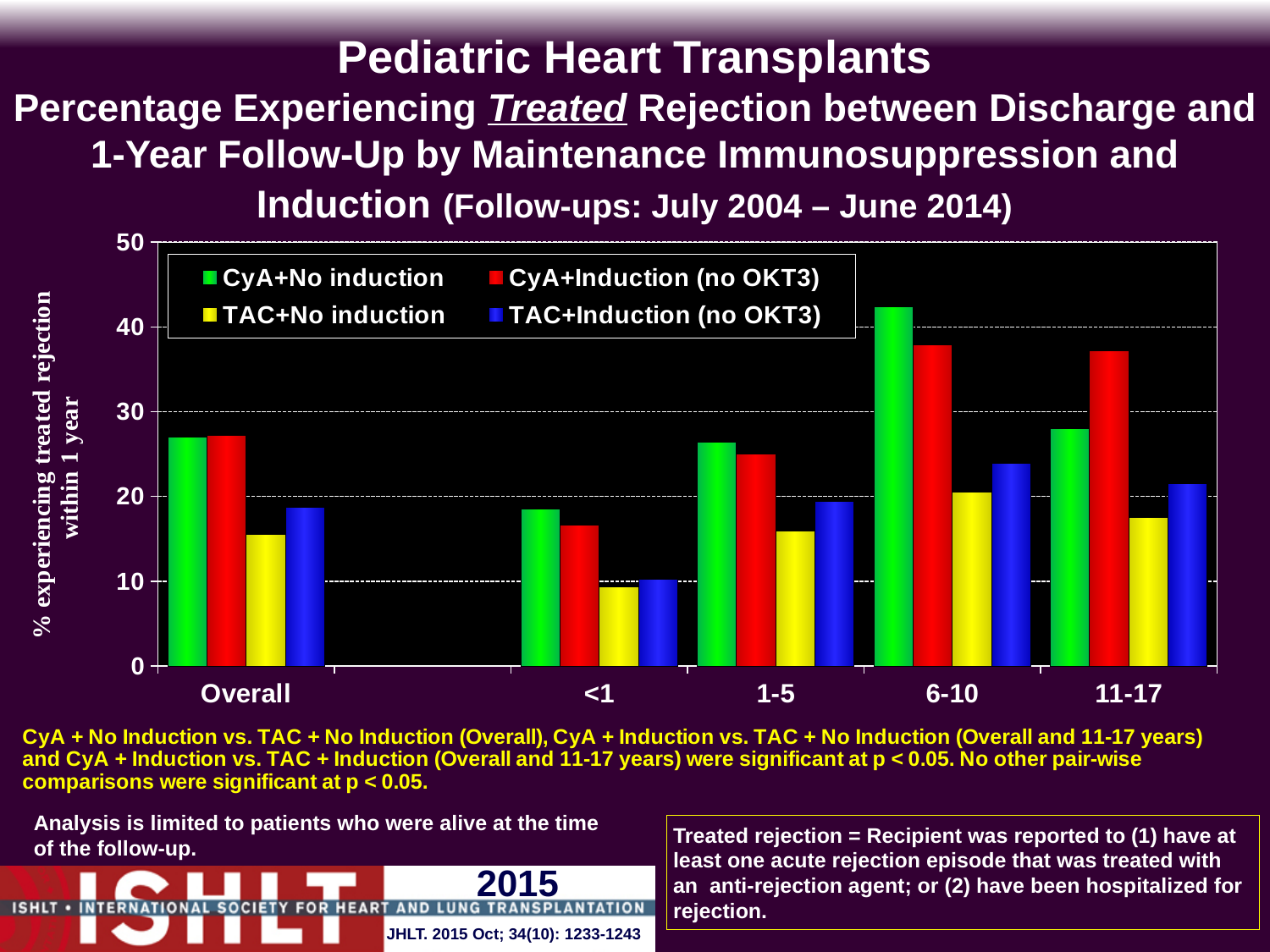
How many series does the legend list? 4 Is the value for CyA+Induction (no OKT3) in the 11-17 group greater or less than 30? greater In the 11-17 group, which is larger: CyA+Induction (no OKT3) or CyA+No induction? CyA+Induction (no OKT3) How many categories are shown along the x axis? 5 Is the value for CyA+No induction in the 6-10 group greater or less than 40? greater What colour represents TAC+No induction in the chart? yellow In the 6-10 group, which is larger: TAC+Induction (no OKT3) or TAC+No induction? TAC+Induction (no OKT3) Which category has the lowest value for TAC+No induction? <1 Which category has the highest value for CyA+No induction? 6-10 What kind of chart is shown on the slide? bar chart Is the value for TAC+No induction in the <1 group greater or less than 10? less In the <1 group, which series has the highest value? CyA+No induction